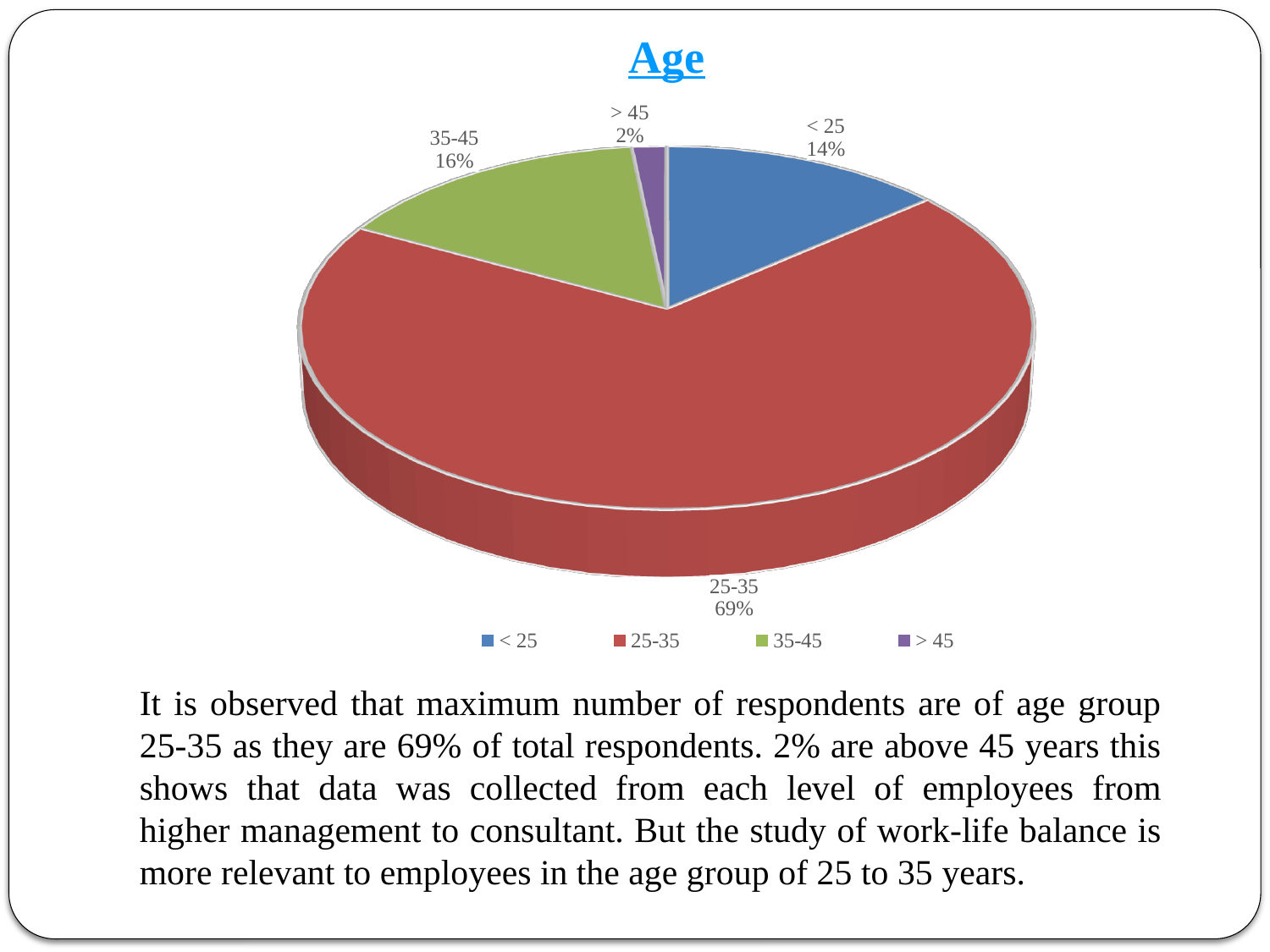
What kind of chart is shown on the slide? Pie chart What share of respondents are in the 25-35 age group? 69% What is the title of the chart? Age What share of respondents are over 45? 2% How many age groups are shown in the pie chart? 4 Which age group has a larger share, < 25 or 35-45? 35-45 What share of respondents are under 25? 14% Which age group has the smallest share of respondents? > 45 Which age group has the largest share of respondents? 25-35 What is the difference in percentage points between the 25-35 and 35-45 age groups? 53 What colour is the slice for the 25-35 age group? Red